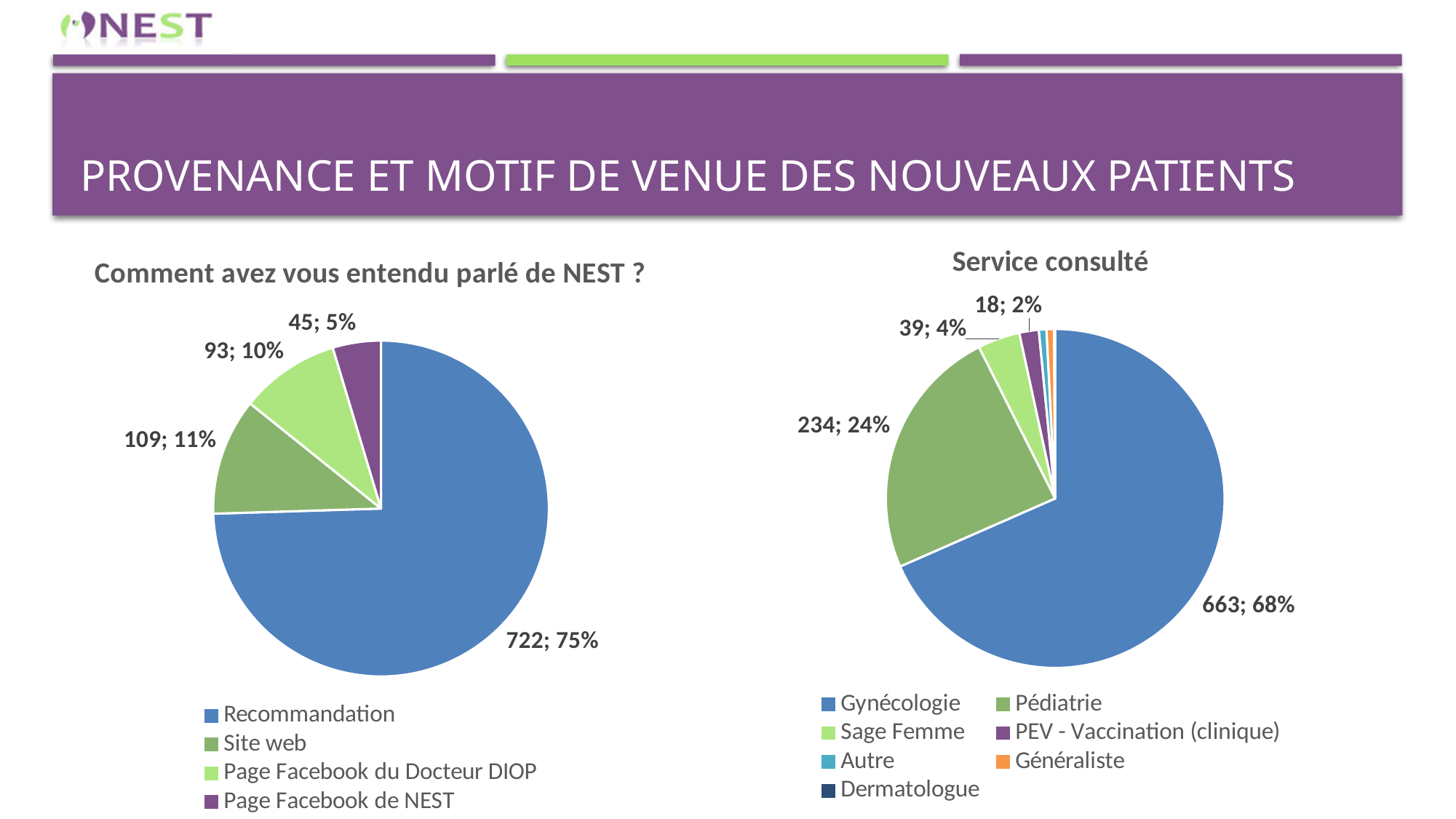
What type of chart is 'Service consulté'? Pie chart In the chart 'Service consulté', how many categories does the legend list? 7 In the chart 'Comment avez vous entendu parlé de NEST ?', what value is shown for Site web? 109; 11% In the chart 'Comment avez vous entendu parlé de NEST ?', how many categories does the legend list? 4 In the chart 'Comment avez vous entendu parlé de NEST ?', what share of the pie does Page Facebook du Docteur DIOP represent? 10% In the chart 'Service consulté', what value is shown for Gynécologie? 663; 68% In the chart 'Service consulté', which is larger, Sage Femme or PEV - Vaccination (clinique)? Sage Femme In the chart 'Service consulté', what value is shown for Pédiatrie? 234; 24% In the chart 'Comment avez vous entendu parlé de NEST ?', which category has the smallest slice? Page Facebook de NEST In the chart 'Comment avez vous entendu parlé de NEST ?', what value is shown for Recommandation? 722; 75% In the chart 'Service consulté', which category has the largest slice? Gynécologie In the chart 'Comment avez vous entendu parlé de NEST ?', what is the difference between the counts for Site web and Page Facebook du Docteur DIOP? 16